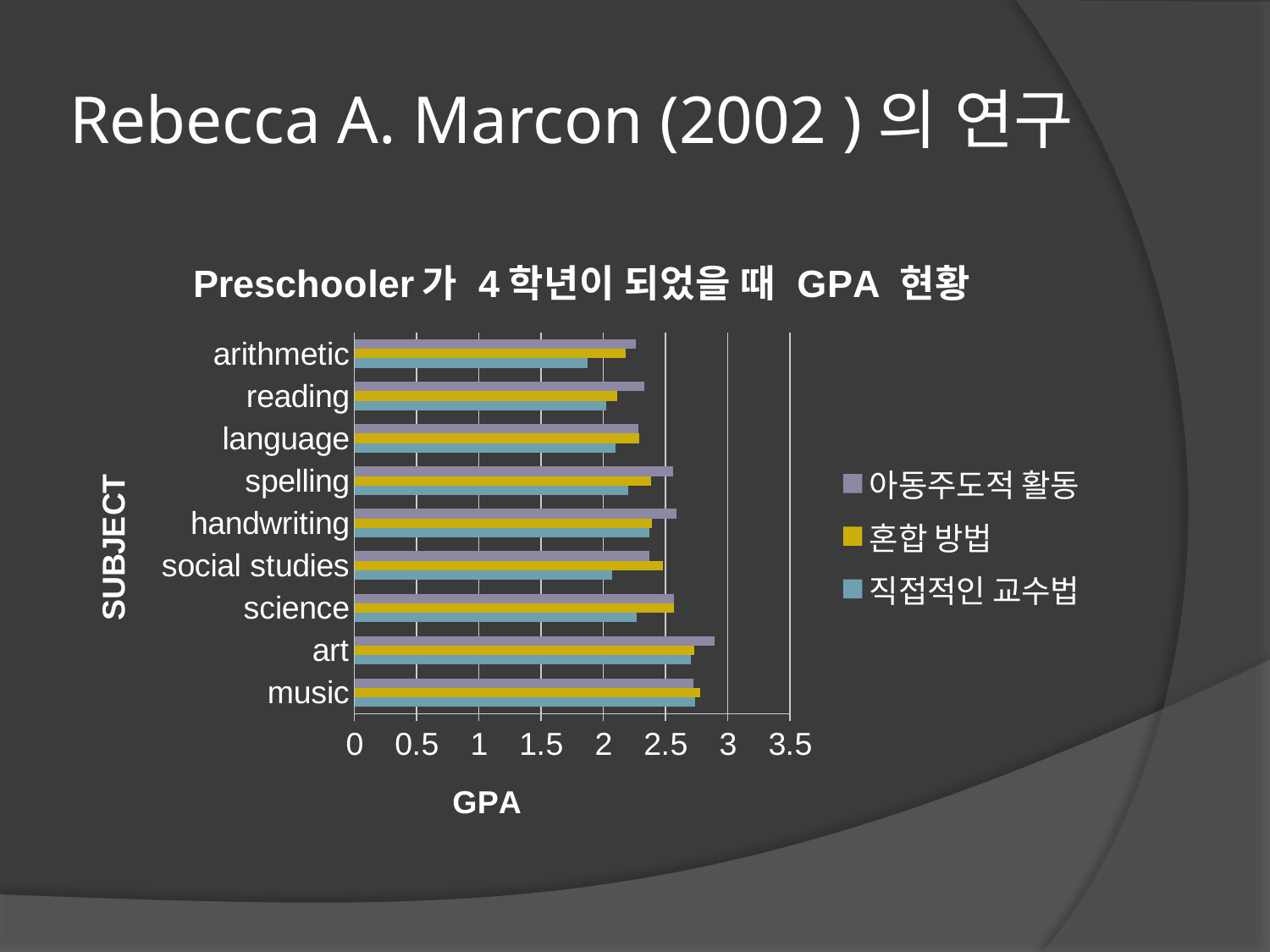
Is the 직접적인 교수법 value for science greater or less than 2? greater How many series does the chart's legend list? 3 Which subject has the highest 아동주도적 활동 value? art Which subject has the lowest 직접적인 교수법 value? arithmetic Is the 혼합 방법 value for music greater or less than 2.5? greater Is the 아동주도적 활동 value for art greater or less than 3? less How many subjects are listed on the vertical axis of the chart? 9 For social studies, which is larger: the 혼합 방법 value or the 직접적인 교수법 value? 혼합 방법 What is the title of the horizontal axis of the chart? GPA What kind of chart is shown on the slide? bar chart